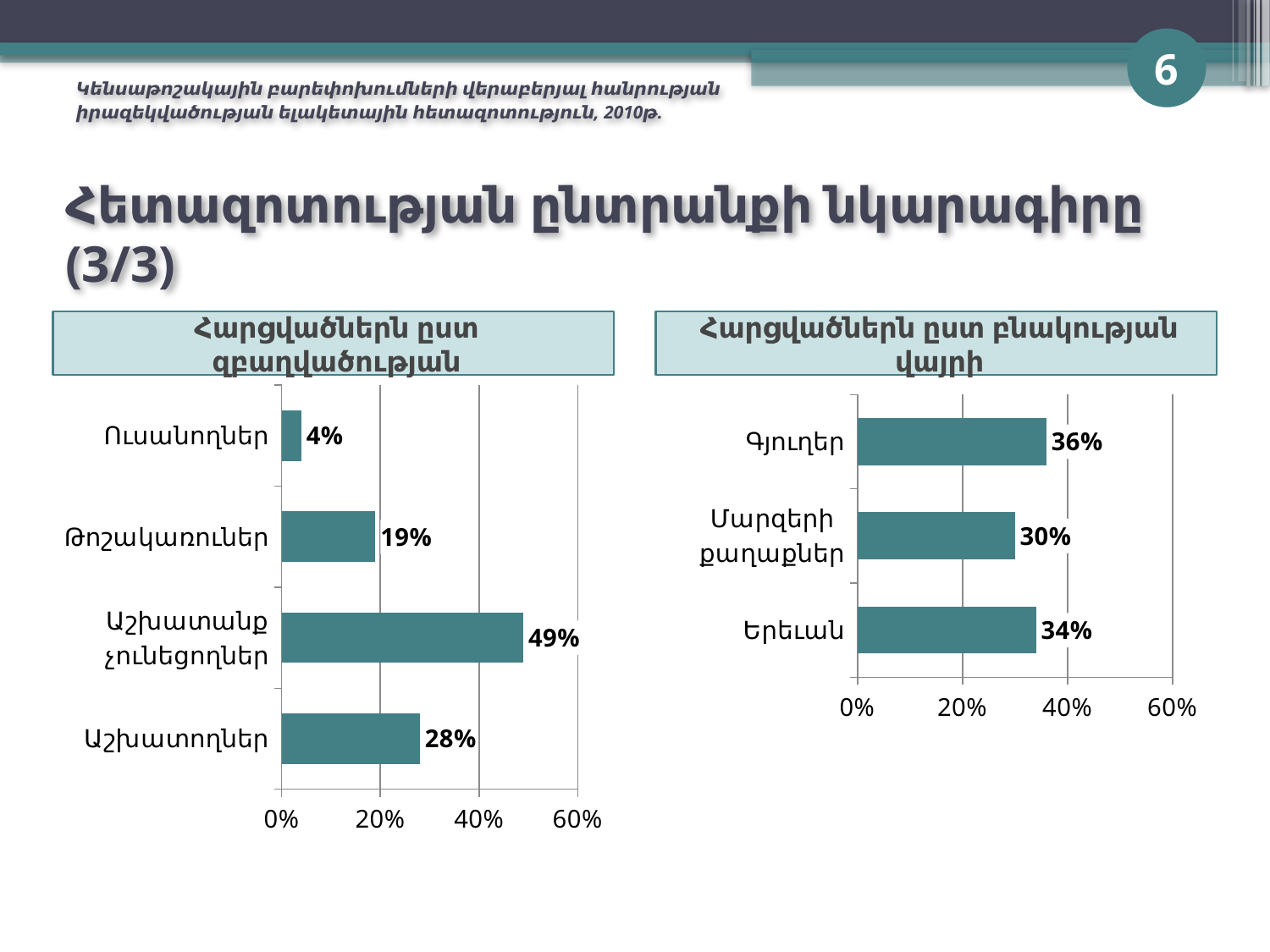
In the left chart (Հարցվածներն ըստ զբաղվածության), which category has the highest value? Աշխատանք չունեցողներ In the left chart (Հարցվածներն ըստ զբաղվածության), which category has the lowest value? Ուսանողներ What type of chart is the right chart (Հարցվածներն ըստ բնակության վայրի)? Bar chart In the left chart (Հարցվածներն ըստ զբաղվածության), what is the difference between Աշխատանք չունեցողներ and Աշխատողներ? 21% In the left chart (Հարցվածներն ըստ զբաղվածության), what is the value for Թոշակառուներ? 19% In the right chart (Հարցվածներն ըստ բնակության վայրի), which is larger, Գյուղեր or Երևան? Գյուղեր In the right chart (Հարցվածներն ըստ բնակության վայրի), which category has the highest value? Գյուղեր In the right chart (Հարցվածներն ըստ բնակության վայրի), what is the value for Երևան? 34% In the right chart (Հարցվածներն ըստ բնակության վայրի), what is the value for Մարզերի քաղաքներ? 30% In the right chart (Հարցվածներն ըստ բնակության վայրի), what is the difference between Գյուղեր and Մարզերի քաղաքներ? 6% In the left chart (Հարցվածներն ըստ զբաղվածության), how many categories are shown? 4 In the left chart (Հարցվածներն ըստ զբաղվածության), what is the value for Ուսանողներ? 4%